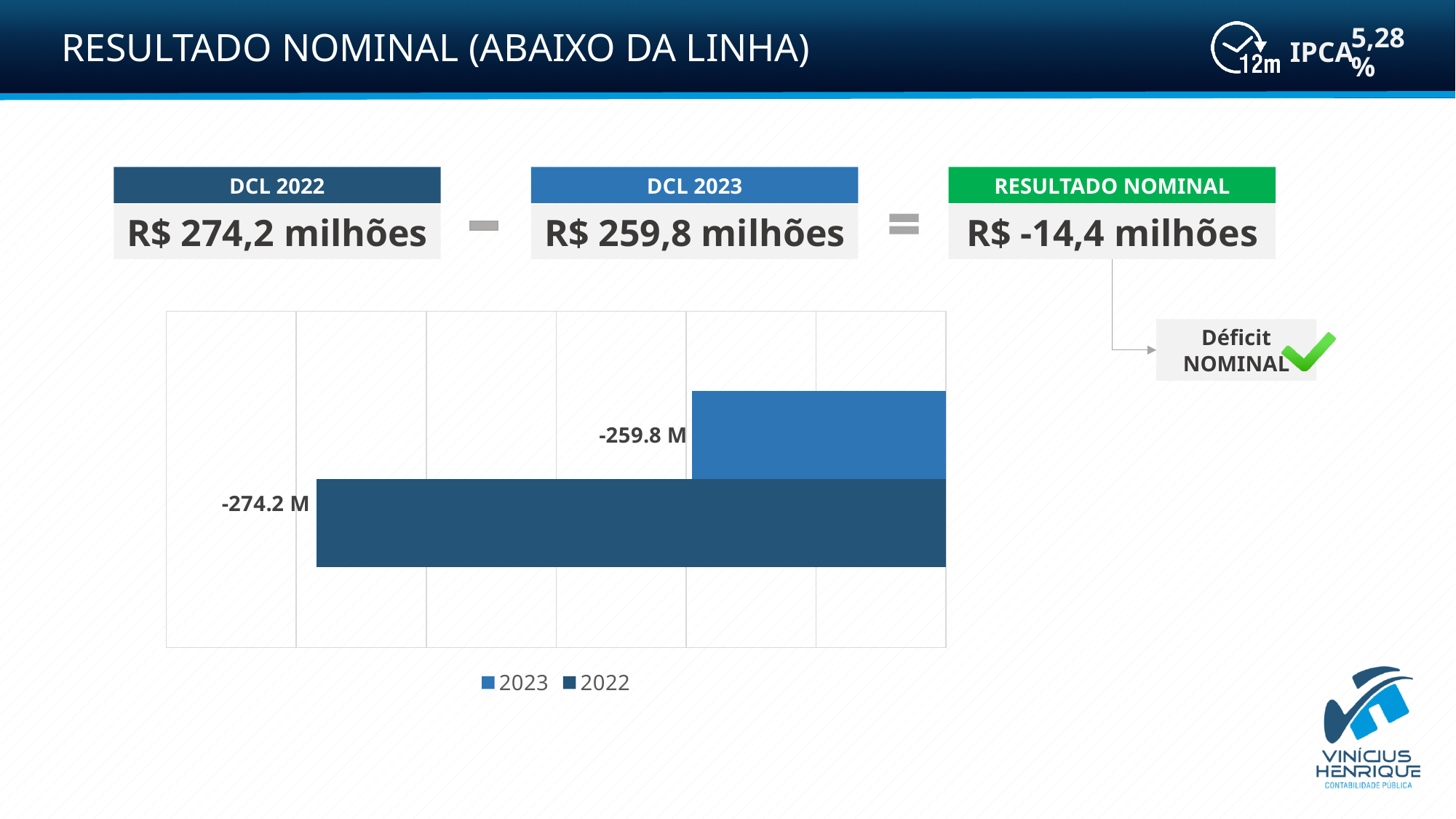
What are the two entries listed in the chart legend? 2023 and 2022 What is the difference between the 2022 and 2023 values shown in the chart? 14.4 M What value is shown for the 2022 bar in the chart? -274.2 M What kind of chart is shown on the slide? Bar chart How many series does the chart legend list? 2 Which series has the lowest (most negative) value in the chart? 2022 How many bars are plotted in the chart? 2 Which series has the longer bar in the chart, 2022 or 2023? 2022 Which series has the highest (least negative) value in the chart? 2023 What value is shown for the 2023 bar in the chart? -259.8 M Which series is shown in the darker blue colour in the chart? 2022